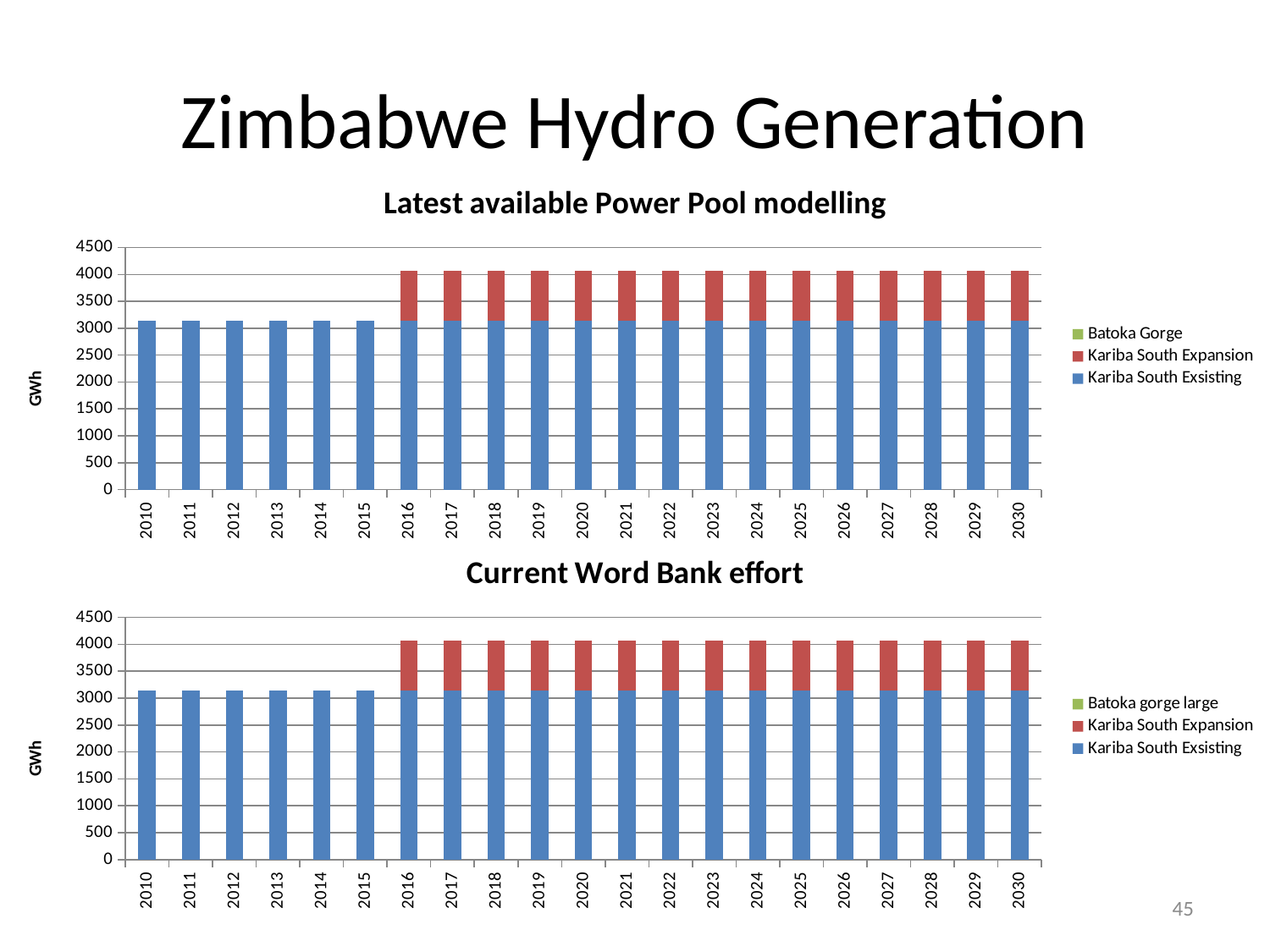
In the 'Latest available Power Pool modelling' chart, which is larger, the total for 2015 or the total for 2016? 2016 In the 'Latest available Power Pool modelling' chart, is the total value for 2010 greater or less than 3000? greater In the 'Current Word Bank effort' chart, is the total value for 2030 greater or less than 4500? less In the 'Latest available Power Pool modelling' chart, how many series does the legend list? 3 In the 'Current Word Bank effort' chart, which series is shown in red? Kariba South Expansion In the 'Latest available Power Pool modelling' chart, is the total value for 2020 greater or less than 3500? greater In the 'Latest available Power Pool modelling' chart, how many years are shown on the x axis? 21 In the 'Current Word Bank effort' chart, in which year does the Kariba South Expansion series first appear? 2016 In the 'Current Word Bank effort' chart, what kind of chart is shown? Stacked bar chart In the 'Current Word Bank effort' chart, do the total values rise, fall, or stay flat from 2016 to 2030? Stay flat In the 'Latest available Power Pool modelling' chart, what is the label on the vertical axis? GWh